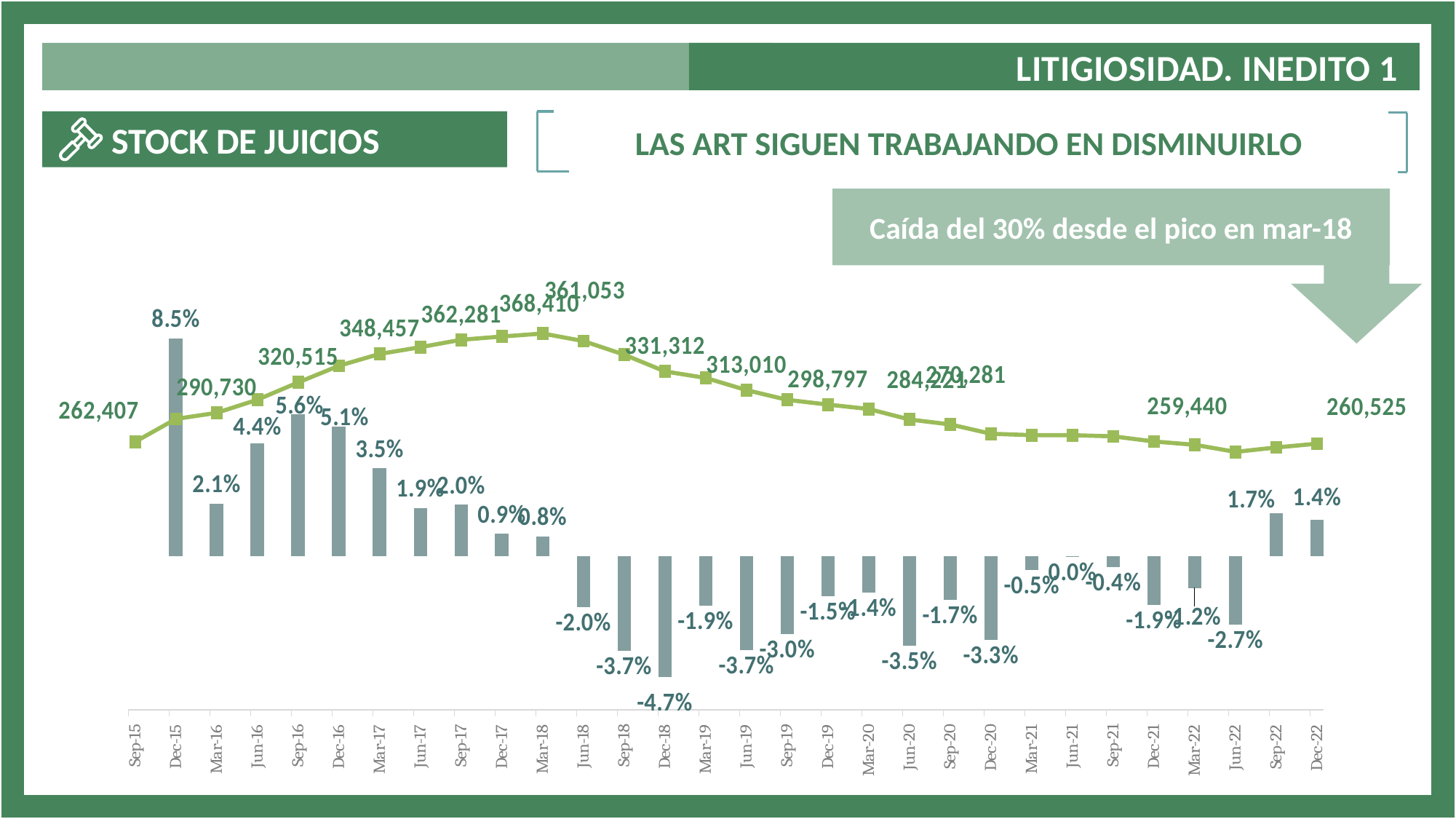
Which bar is larger, Sep-16 or Dec-16? Sep-16 What is the stock of lawsuits value labelled at the first point of the line (Sep-15)? 262,407 What is the percentage change shown by the bar for Jun-21? 0.0% Which quarter has the lowest percentage-change bar? Dec-18 Which quarter has the highest percentage-change bar? Dec-15 What is the percentage change shown by the bar for Dec-18? -4.7% What kind of chart is shown on the slide? A combined line and bar chart What is the stock of lawsuits value labelled at the last point of the line (Dec-22)? 260,525 What is the percentage change shown by the bar for Dec-15? 8.5% What is the difference in percentage points between the bars for Dec-15 (8.5%) and Mar-16 (2.1%)? 6.4 percentage points What does the callout box above the chart say? Caída del 30% desde el pico en mar-18 How many quarters are shown on the x axis? 30